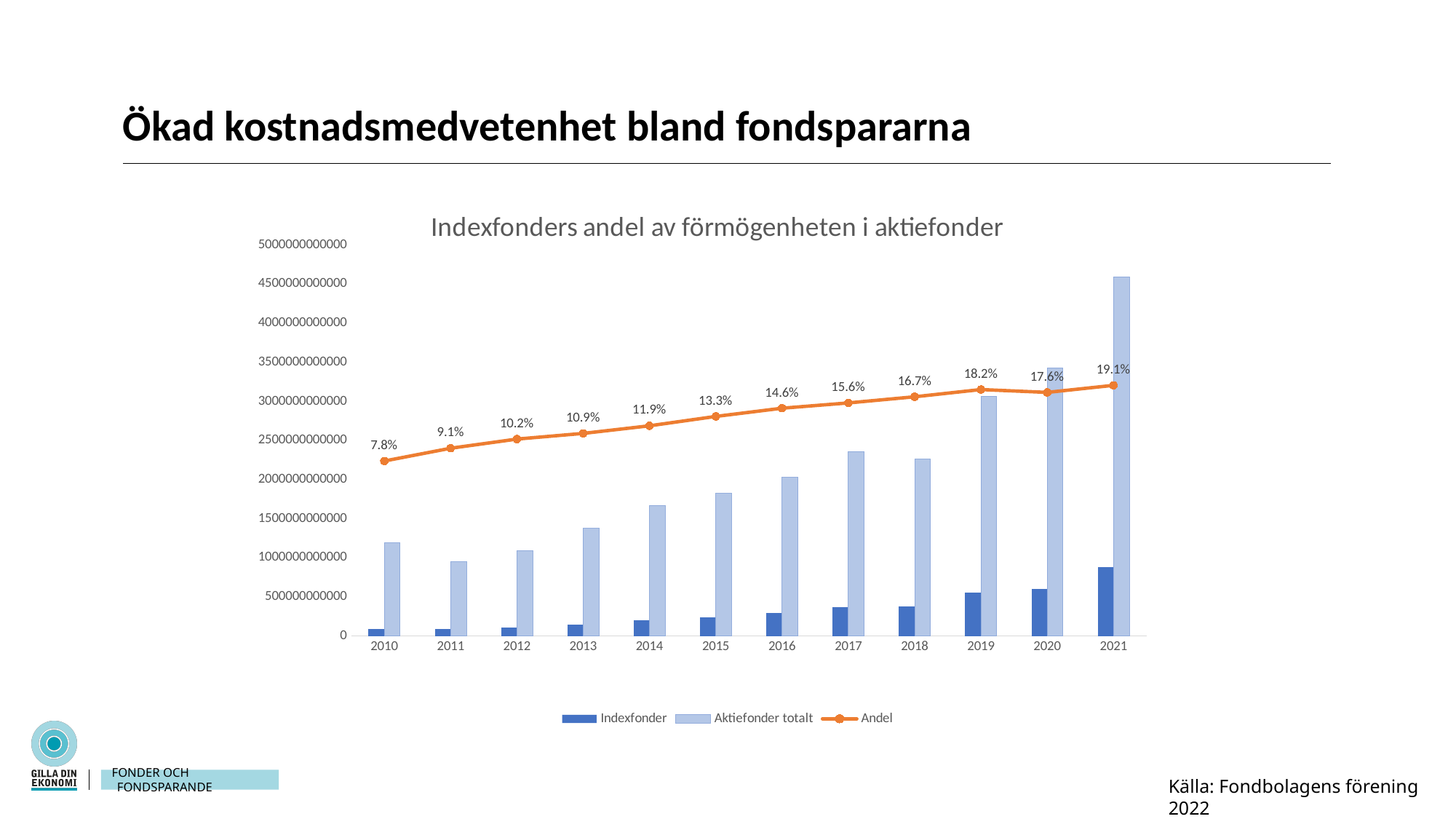
In which year is the Andel value lowest? 2010 What is the title of the chart? Indexfonders andel av förmögenheten i aktiefonder What is the Andel value for 2021? 19.1% Is the Indexfonder bar for 2021 greater or less than 1000000000000? less Is the Aktiefonder totalt bar for 2021 greater or less than 4000000000000? greater In which year is the Andel value highest? 2021 What is the Andel value for 2016? 14.6% What is the difference in percentage points between the Andel value for 2021 and for 2010? 11.3 What is the Andel value for 2010? 7.8% How many years are shown on the x axis? 12 Which year has the larger Andel value, 2019 or 2020? 2019 How many series does the legend list? 3